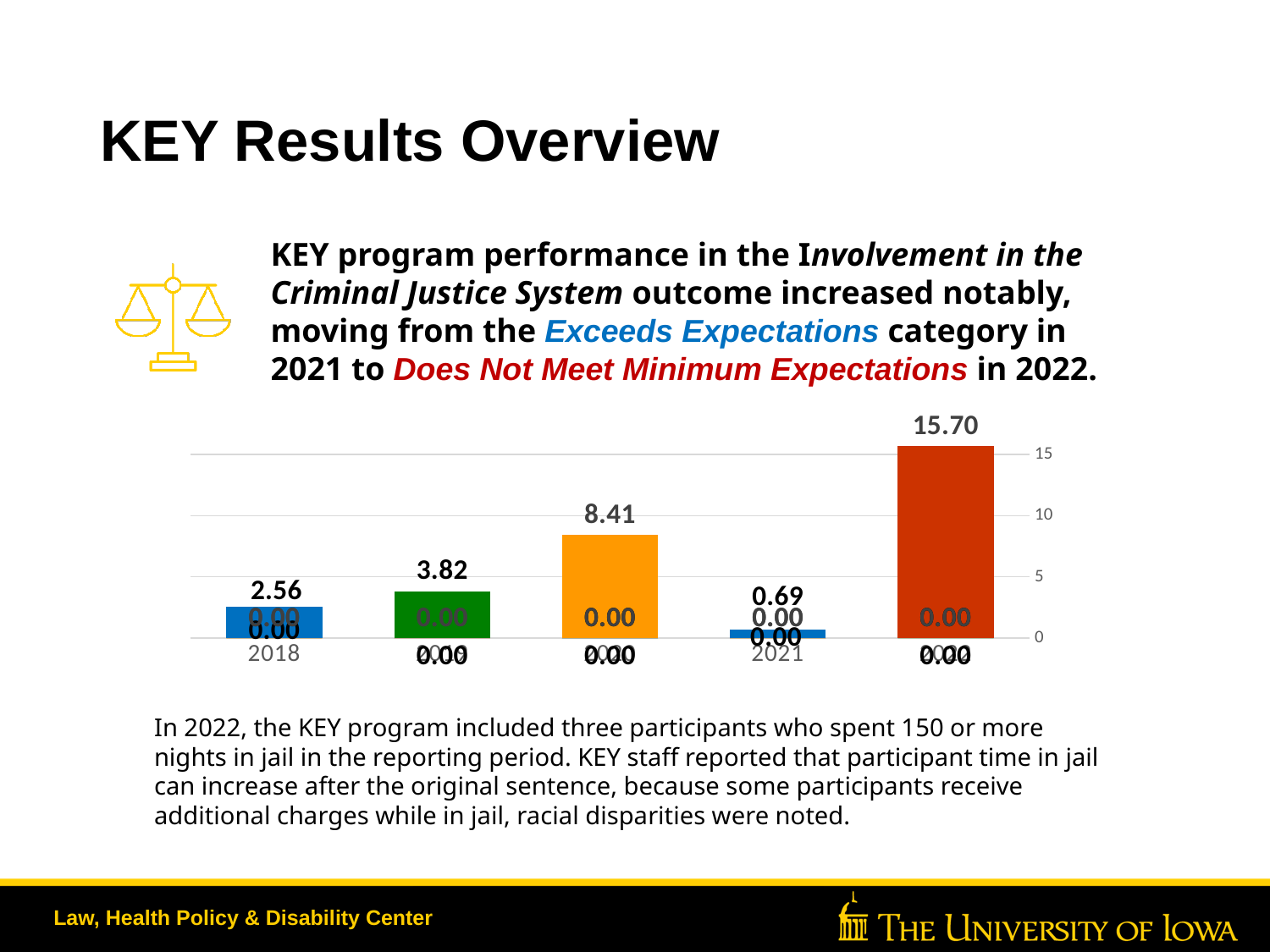
What is the value shown for 2021 in the bar chart? 0.69 What value is labelled on the orange bar in the chart? 8.41 What value is labelled on the tallest (red) bar in the chart? 15.70 Is the value of the red bar greater or less than 15? greater What is the difference between the orange bar's value (8.41) and the green bar's value (3.82)? 4.59 What kind of chart is shown on the slide? bar chart Which is larger, the value for 2018 or the value for 2021? 2018 Which year has the lowest value in the bar chart? 2021 What is the value shown for 2018 in the bar chart? 2.56 How many bars are plotted in the chart? 5 What is the highest value labelled on any bar in the chart? 15.70 What is the difference between the value for 2018 and the value for 2021? 1.87